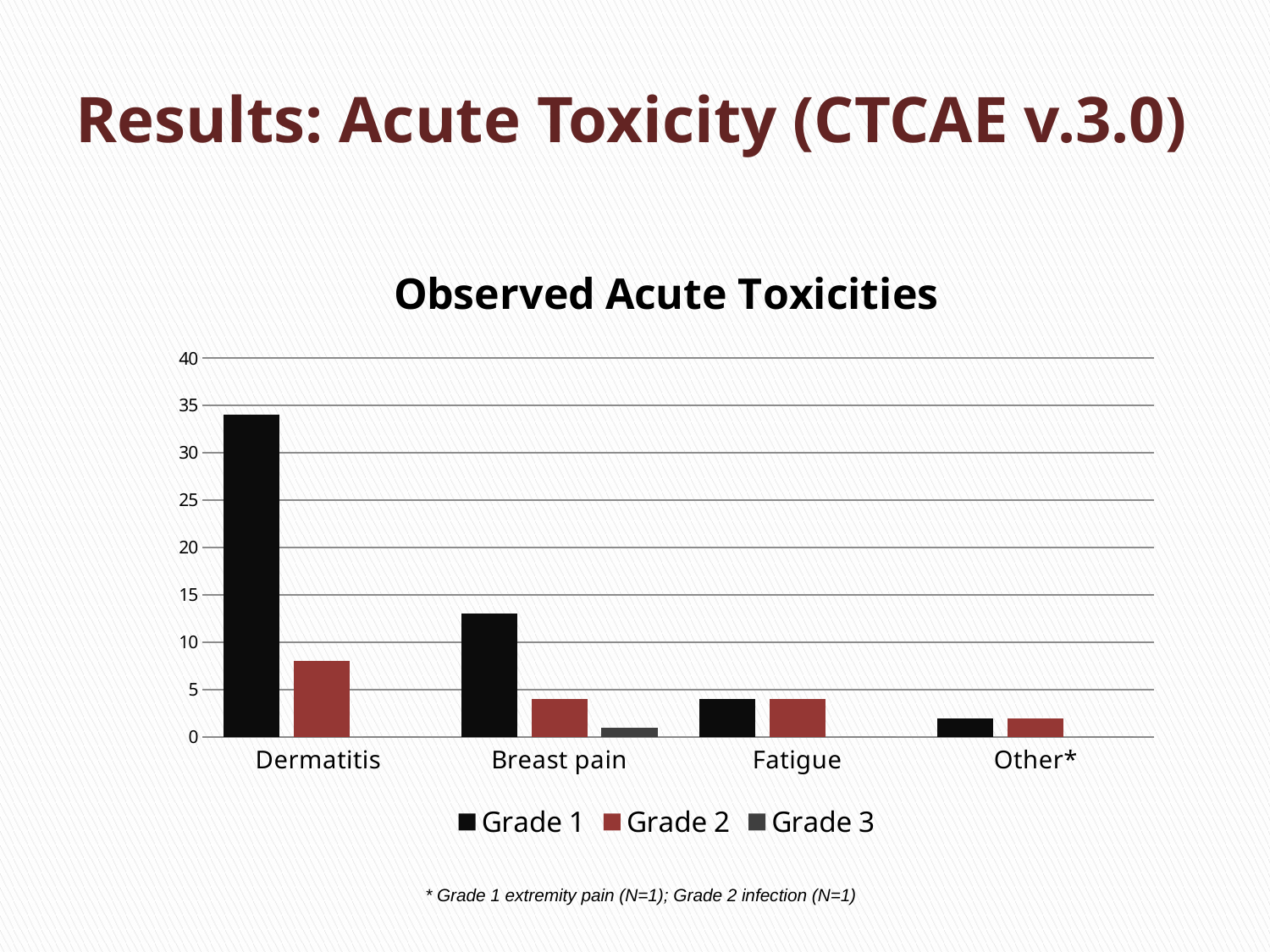
Is the Grade 2 value for Dermatitis greater or less than 10? less Which category is the only one with a visible Grade 3 bar? Breast pain How many series does the legend list? 3 What is the title of the chart? Observed Acute Toxicities What kind of chart is shown on the slide? Bar chart Which is larger, the Grade 1 value for Dermatitis or the Grade 1 value for Breast pain? Dermatitis Do the Grade 1 values rise or fall moving from Dermatitis to Other* along the x axis? fall Which category has the highest Grade 2 value? Dermatitis Which category has the highest Grade 1 value? Dermatitis How many toxicity categories are shown on the x axis? 4 Is the Grade 1 value for Breast pain greater or less than 10? greater Is the Grade 1 value for Dermatitis greater or less than 30? greater